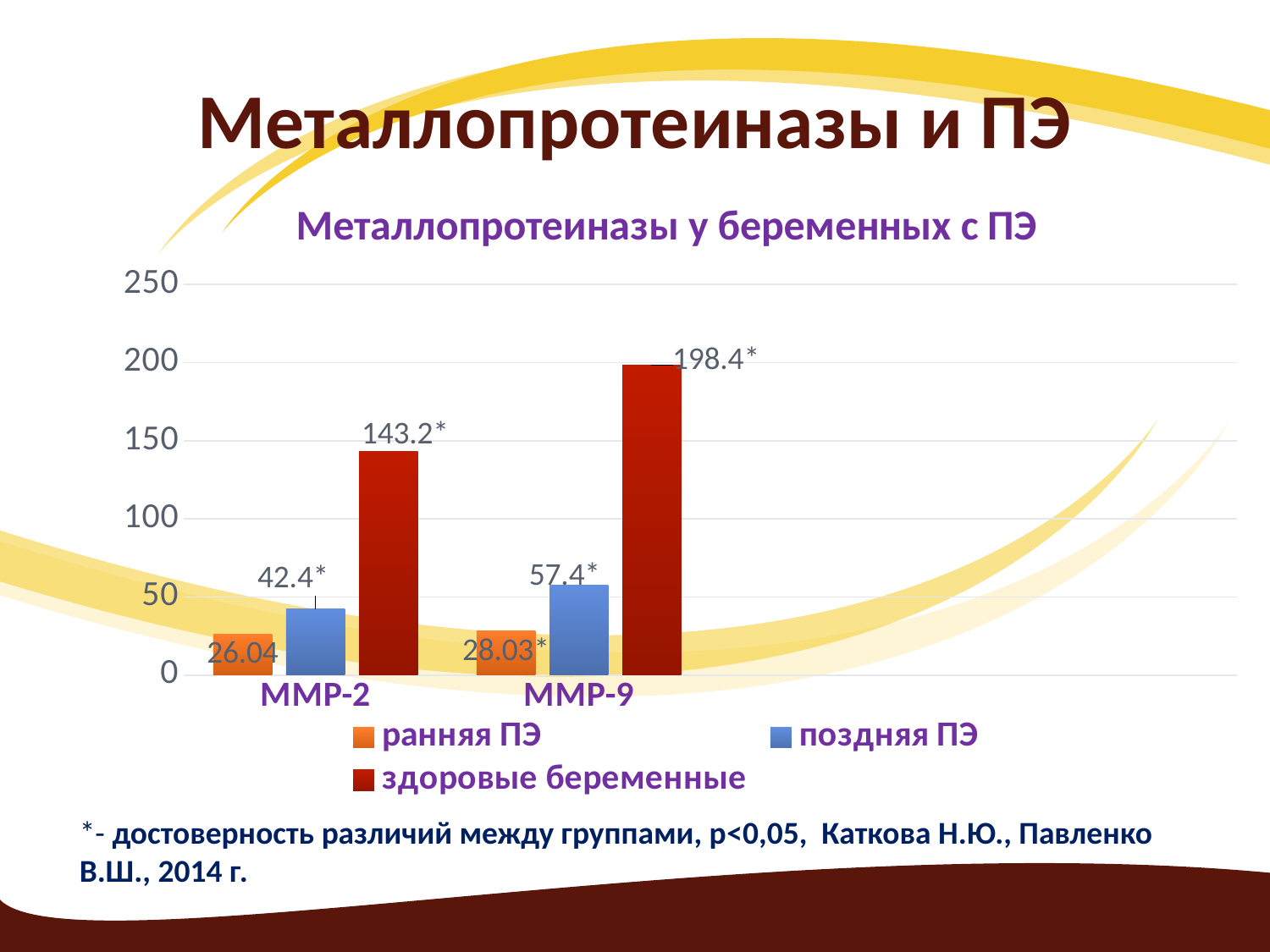
What is the value for ранняя ПЭ in the MMP-2 category? 26.04 What kind of chart is shown on the slide? Bar chart Which series has the lowest value in the MMP-2 category? ранняя ПЭ Which series has the highest value in the MMP-9 category? здоровые беременные What is the value for здоровые беременные in the MMP-9 category? 198.4 What is the title of the chart? Металлопротеиназы у беременных с ПЭ Which is larger: the поздняя ПЭ value for MMP-2 or the поздняя ПЭ value for MMP-9? MMP-9 How many series does the legend list? 3 What is the difference between the поздняя ПЭ values for MMP-9 and MMP-2? 15 What is the value for здоровые беременные in the MMP-2 category? 143.2 What is the value for поздняя ПЭ in the MMP-9 category? 57.4 What is the difference between the здоровые беременные values for MMP-9 and MMP-2? 55.2